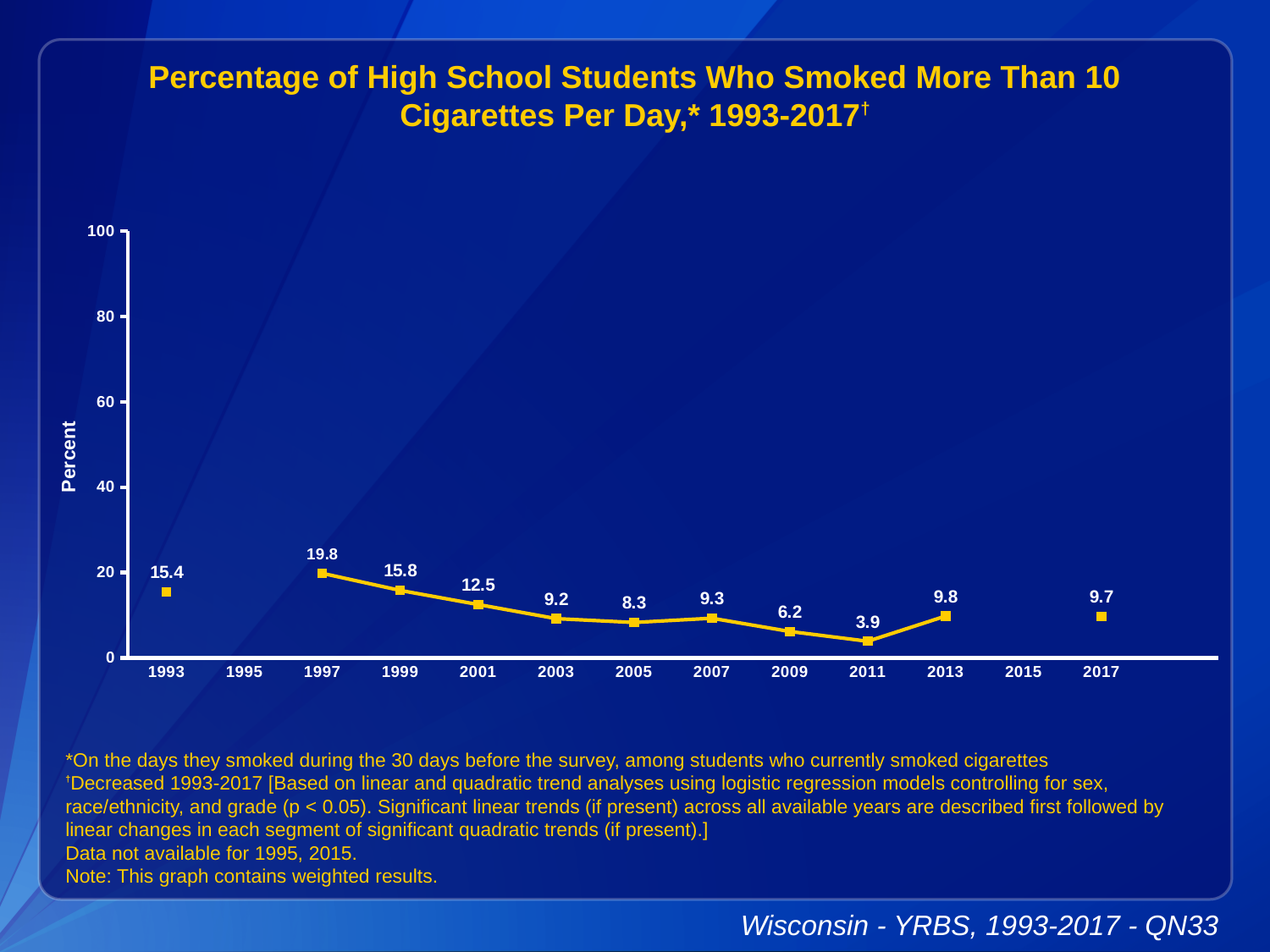
What is the difference between the values for 2013 and 2011? 5.9 Which year has the lowest value? 2011 Which year has the highest value? 1997 What is the value for 2017? 9.7 What is the difference between the values for 1997 and 1999? 4 Is the value for 1997 greater or less than 20? less Which is larger, the value for 1993 or the value for 1999? 1999 Do the values generally rise or fall from 1997 to 2011? fall How many years have data points plotted on the chart? 11 What is the value for 2011? 3.9 What is the value for 1997? 19.8 What kind of chart is this? line chart